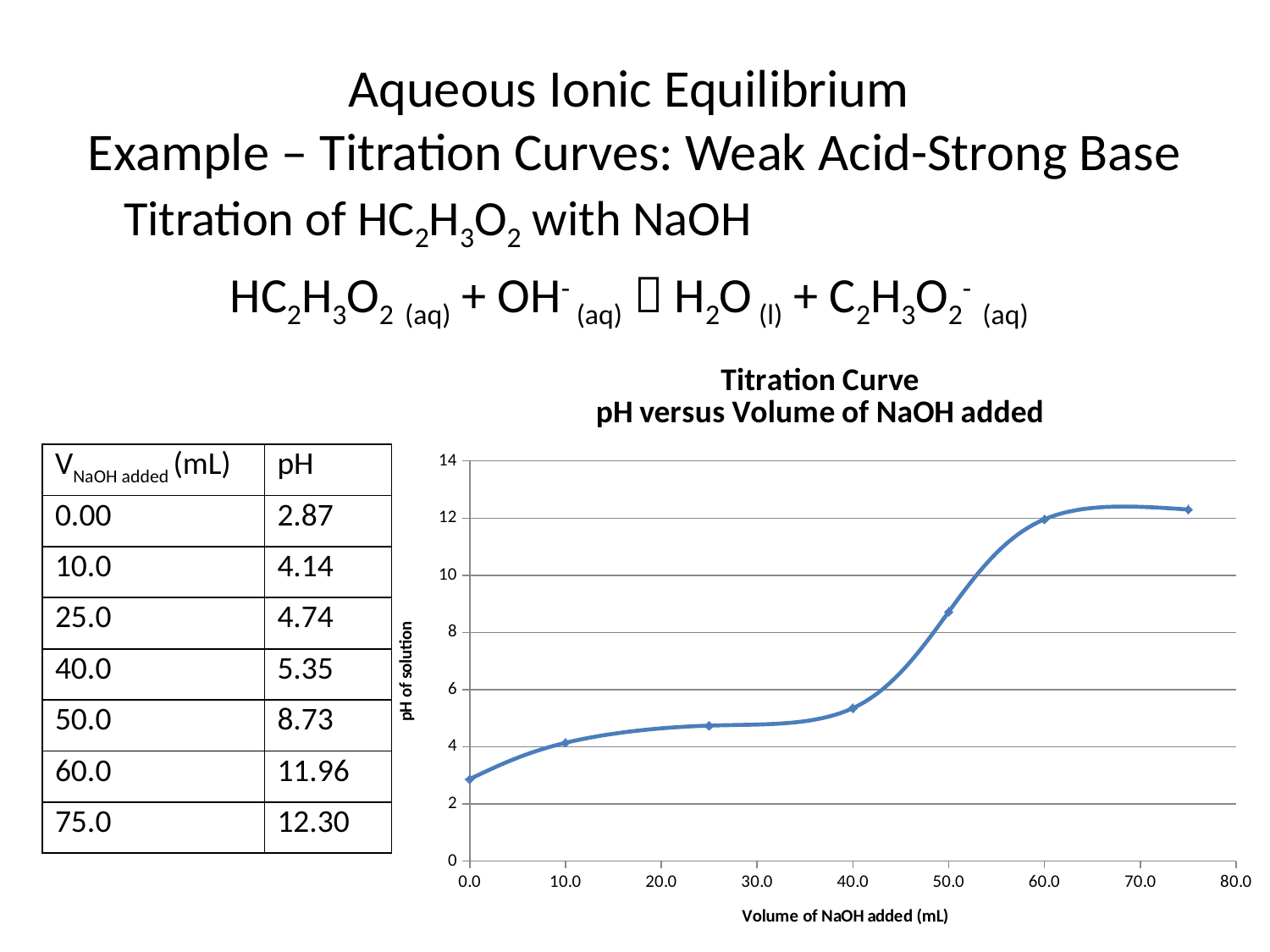
What is the pH when 0.00 mL of NaOH has been added? 2.87 What is the label of the x axis of the chart? Volume of NaOH added (mL) What is the difference in pH between 60.0 mL and 50.0 mL of NaOH added? 3.23 At which volume of NaOH added is the pH lowest? 0.00 Does the pH rise or fall as the volume of NaOH added increases? rise Is the pH at 25.0 mL of NaOH added greater or less than 6? less At which volume of NaOH added is the pH highest? 75.0 What is the pH when 50.0 mL of NaOH has been added? 8.73 What kind of chart is shown on the slide? line chart How many data points are plotted on the titration curve? 7 What is the pH when 60.0 mL of NaOH has been added? 11.96 What is the title of the chart? Titration Curve pH versus Volume of NaOH added